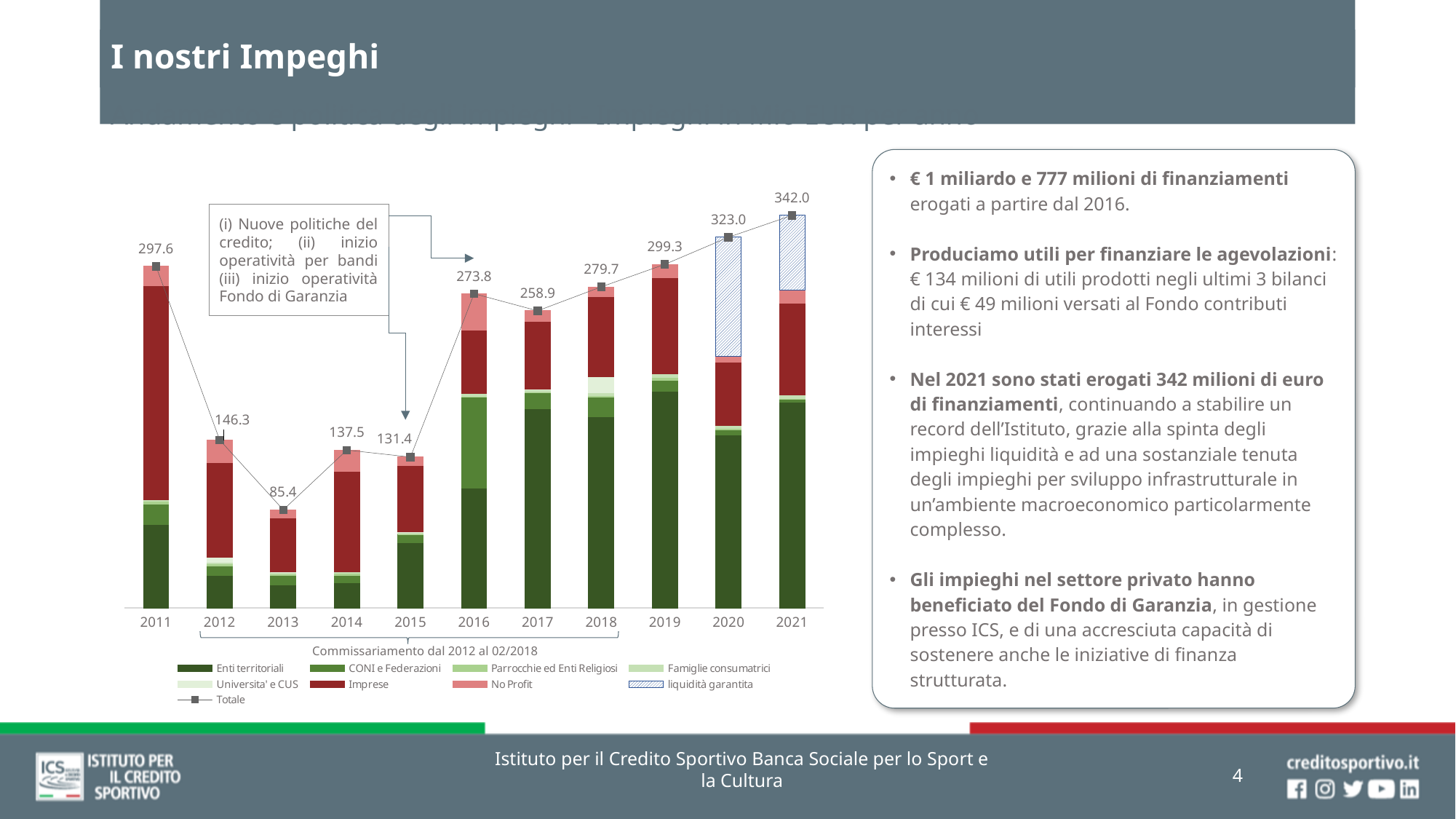
What kind of chart is shown on the slide? Stacked bar chart with a line for the total Do the total values rise or fall from 2016 to 2021? Rise Which year has the lowest total value? 2013 Which year has the highest total value? 2021 Which is larger, the total for 2017 or the total for 2018? 2018 What is the total value shown for 2016? 273.8 What is the difference between the total for 2021 and the total for 2020? 19.0 What is the total value shown for 2013? 85.4 What is the total value shown for 2021? 342.0 How many entries does the legend list? 9 How many years are shown on the x axis? 11 What is the difference between the total for 2011 and the total for 2012? 151.3